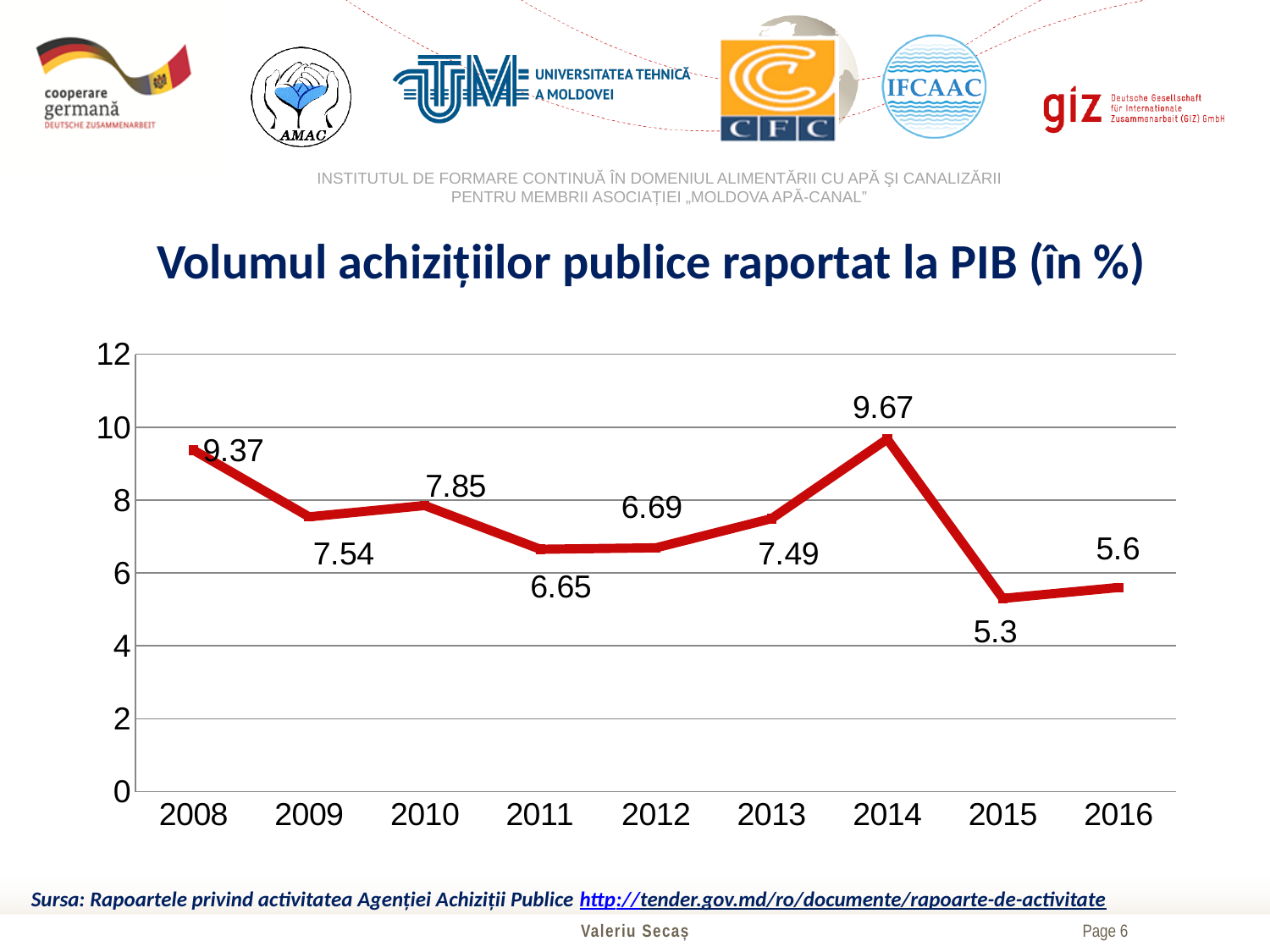
Which year has the highest value? 2014 Which is larger, the value for 2008 or the value for 2010? 2008 Is the value for 2013 greater or less than 8? less Does the value rise or fall from 2014 to 2015? fall What is the title of the chart? Volumul achizițiilor publice raportat la PIB (în %) Which year has the lowest value? 2015 What is the value for 2014? 9.67 What is the value for 2011? 6.65 What is the value for 2016? 5.6 What kind of chart is shown on the slide? line chart What is the difference between the values for 2014 and 2015? 4.37 How many years are plotted on the x axis? 9